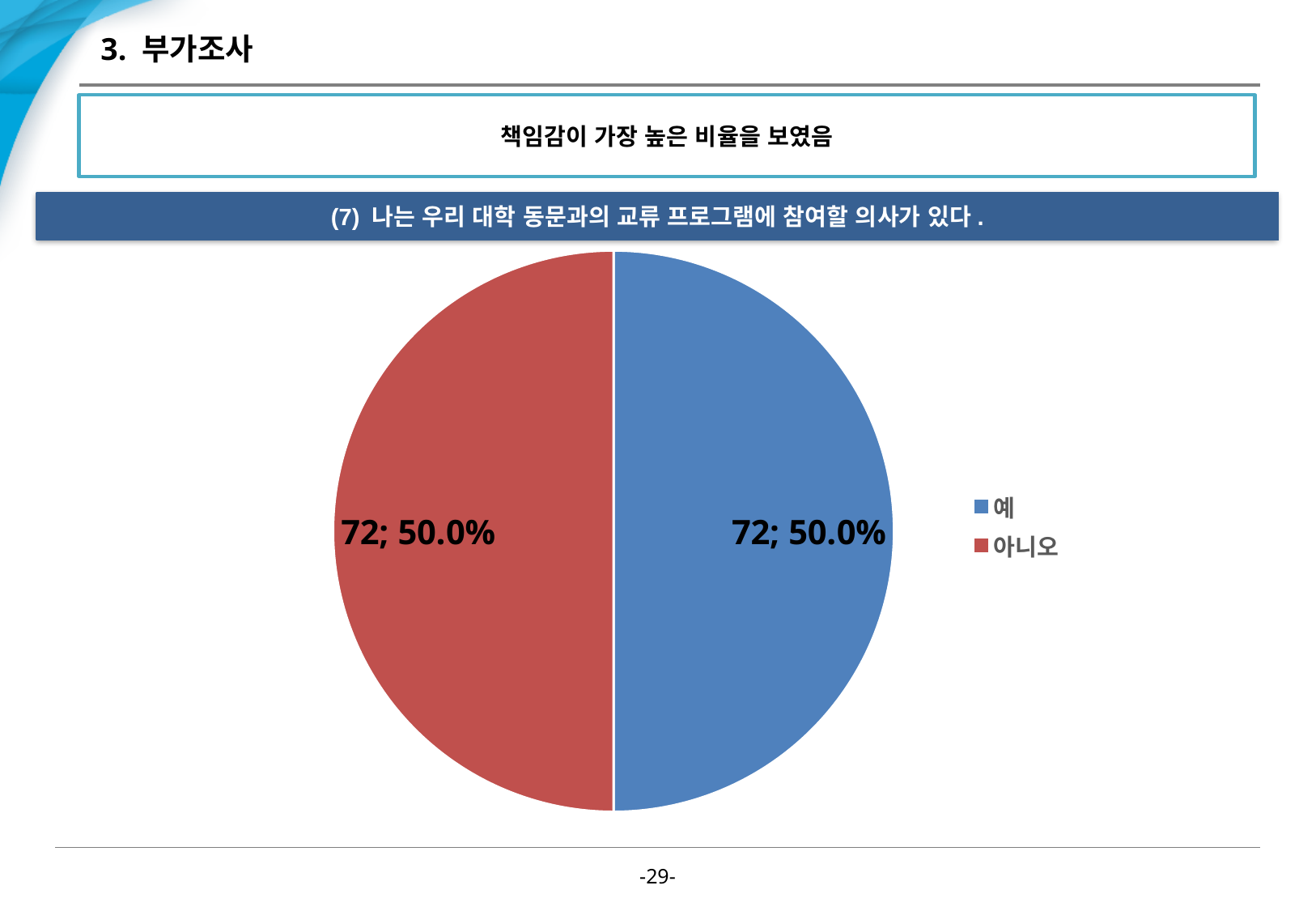
What share of the pie does the 예 slice represent? 50.0% Which legend entry is shown in blue in the pie chart? 예 What is the count shown for the 아니오 slice of the pie chart? 72 What kind of chart is shown on the slide? pie chart What share of the pie does the 아니오 slice represent? 50.0% How many entries does the legend of the pie chart list? 2 What is the total of the counts shown on the two slices of the pie chart? 144 How many slices does the pie chart have? 2 What is the difference between the counts for 예 and 아니오 in the pie chart? 0 What is the count shown for the 예 slice of the pie chart? 72 Which legend entry is shown in red in the pie chart? 아니오